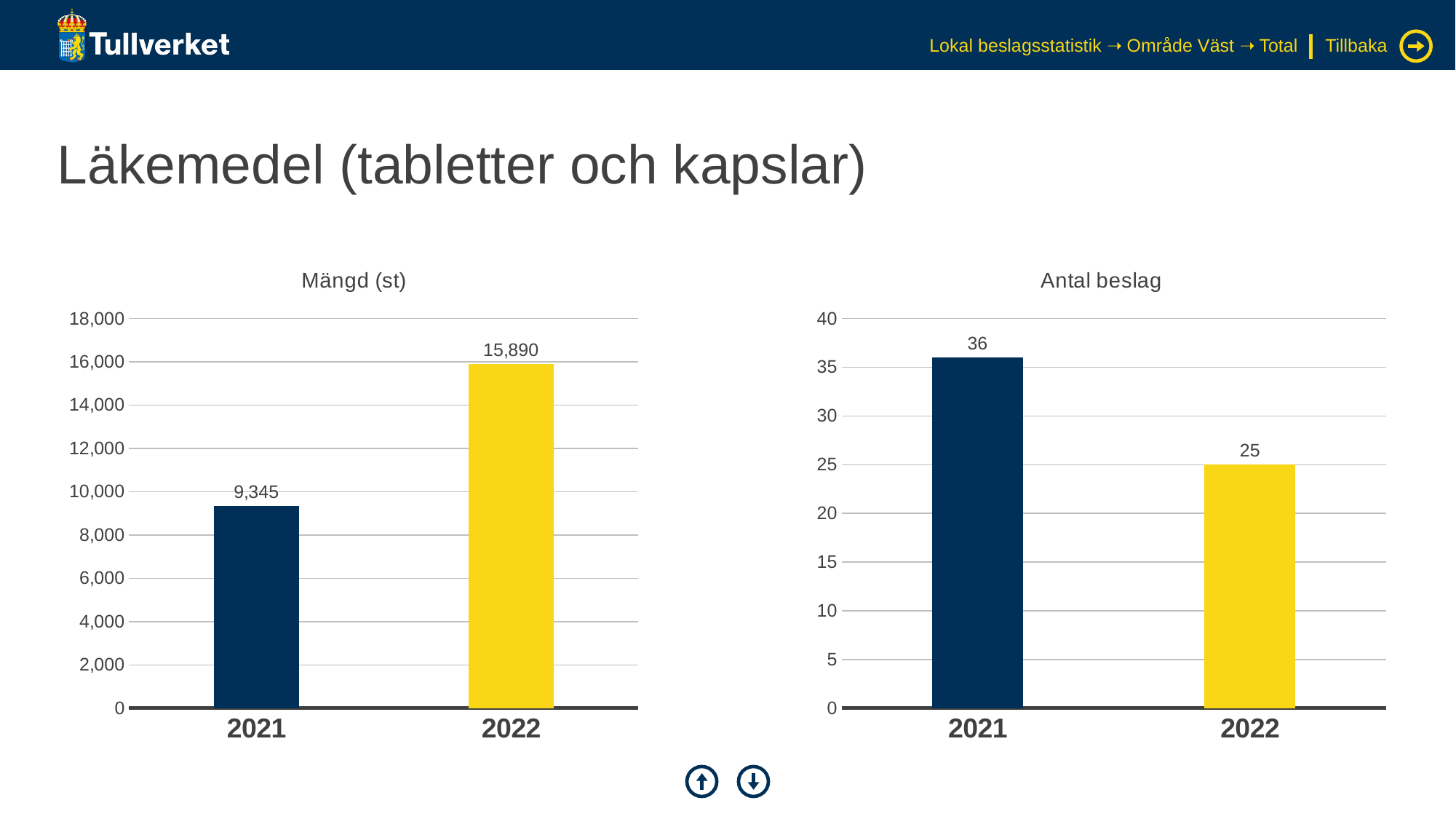
In the "Mängd (st)" chart, which year has the highest value? 2022 In the "Mängd (st)" chart, what is the value for 2022? 15,890 In the "Antal beslag" chart, what is the value for 2022? 25 In the "Antal beslag" chart, which year has the lowest value? 2022 In the "Antal beslag" chart, do the values rise or fall from 2021 to 2022? fall In the "Mängd (st)" chart, what is the difference between the 2022 and 2021 values? 6,545 In the "Antal beslag" chart, what is the value for 2021? 36 In the "Mängd (st)" chart, what is the value for 2021? 9,345 What kind of chart is the "Antal beslag" chart? bar chart In the "Antal beslag" chart, is the value for 2021 greater or less than 30? greater In the "Antal beslag" chart, what is the difference between the 2021 and 2022 values? 11 In the "Mängd (st)" chart, how many years are shown on the x axis? 2